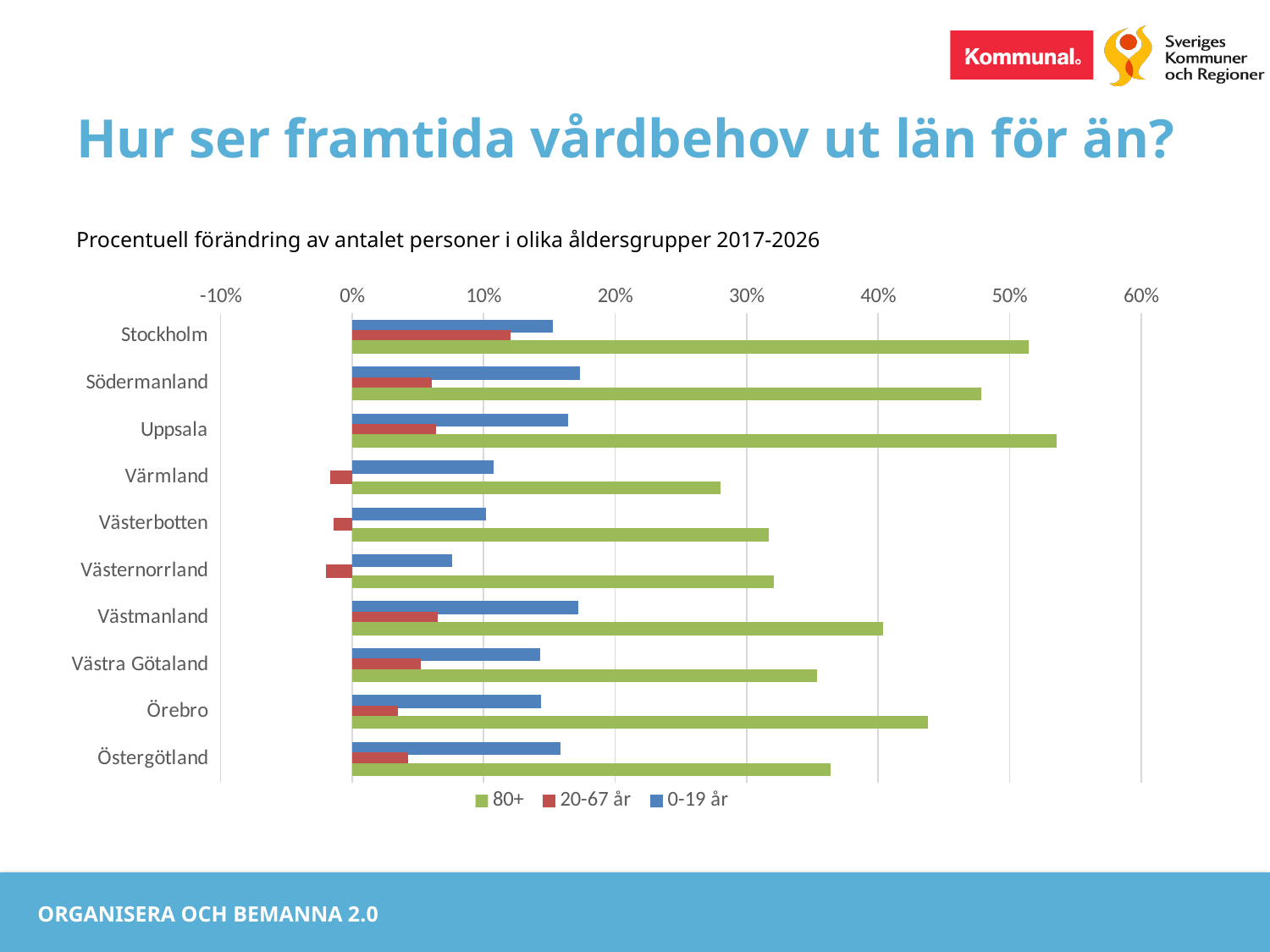
What is the subtitle printed above the chart? Procentuell förändring av antalet personer i olika åldersgrupper 2017-2026 Is the 80+ value for Värmland greater or less than 30%? less Which county has the highest value for the 80+ series? Uppsala Which county has the lowest value for the 0-19 år series? Västernorrland What kind of chart is shown on the slide? bar chart Which county has the highest value for the 20-67 år series? Stockholm Is the 20-67 år value for Västernorrland greater or less than 0%? less Which is larger for Örebro: the 80+ value or the 0-19 år value? 80+ Which county has the lowest value for the 80+ series? Värmland Is the 80+ value for Stockholm greater or less than 50%? greater How many series does the legend list? 3 How many counties (categories) are shown on the chart? 10